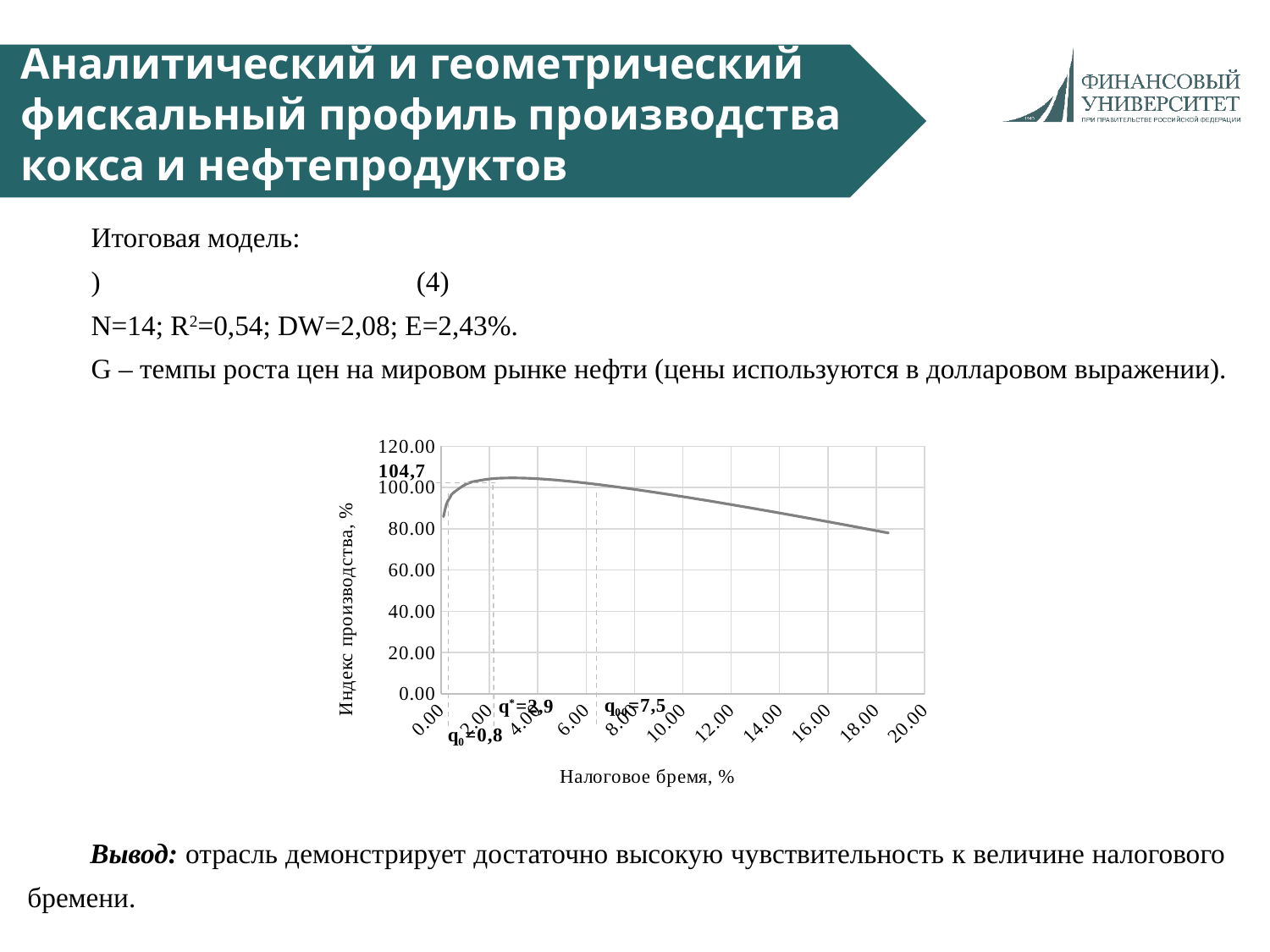
What value of q0 is marked on the chart? 0,8 What is the title of the horizontal axis? Налоговое бремя, % Is the production index at a tax burden of 4.00 greater or less than 100? greater What is the maximum value of the production index marked on the chart? 104,7 Is the production index at a tax burden of 10.00 greater or less than 80? greater What value of q00 is marked on the chart? 7,5 Is the production index at a tax burden of 10.00 greater or less than 100? less After the peak, do the values of the production index rise or fall as the tax burden increases? fall What kind of chart is shown on the slide? line chart What is the highest tick value shown on the vertical axis? 120.00 What value of q* (the tax burden at the peak) is marked on the chart? 2,9